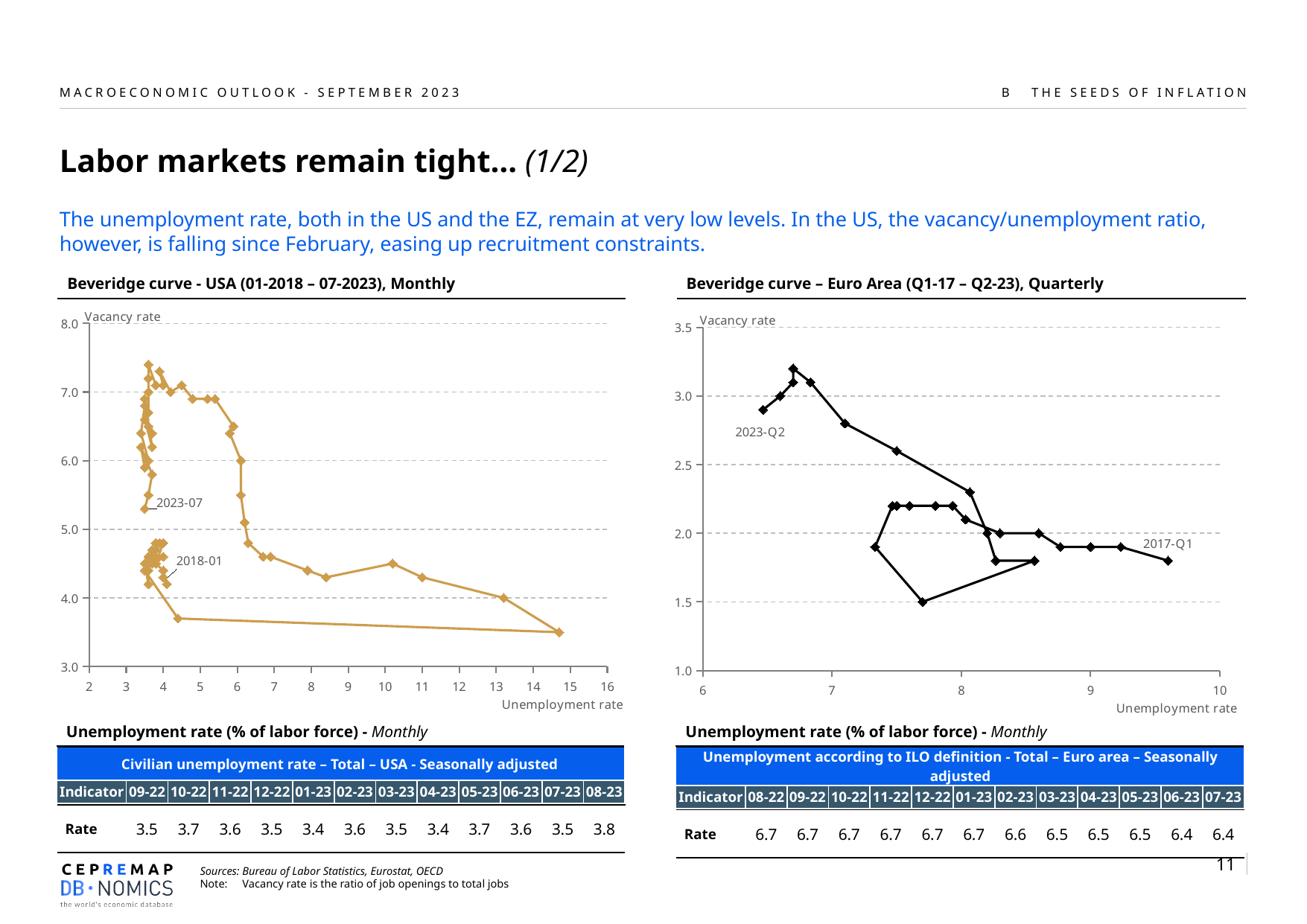
On the Beveridge curve - USA chart, is the unemployment rate of the point labelled 2023-07 greater or less than 4? less In the USA unemployment rate table below the left chart, what is the rate for 08-23? 3.8 On the Beveridge curve – Euro Area chart, what is the label of the vertical axis? Vacancy rate On the Beveridge curve – Euro Area chart, is the vacancy rate of the point labelled 2023-Q2 greater or less than 3.0? less On the Beveridge curve - USA chart, is the vacancy rate of the point with the highest unemployment rate greater or less than 4.0? less What kind of chart is the Beveridge curve - USA chart? line chart On the Beveridge curve - USA chart, what is the label of the horizontal axis? Unemployment rate On the Beveridge curve – Euro Area chart, which point has the higher vacancy rate, 2023-Q2 or 2017-Q1? 2023-Q2 On the Beveridge curve - USA chart, which point has the higher vacancy rate, 2023-07 or 2018-01? 2023-07